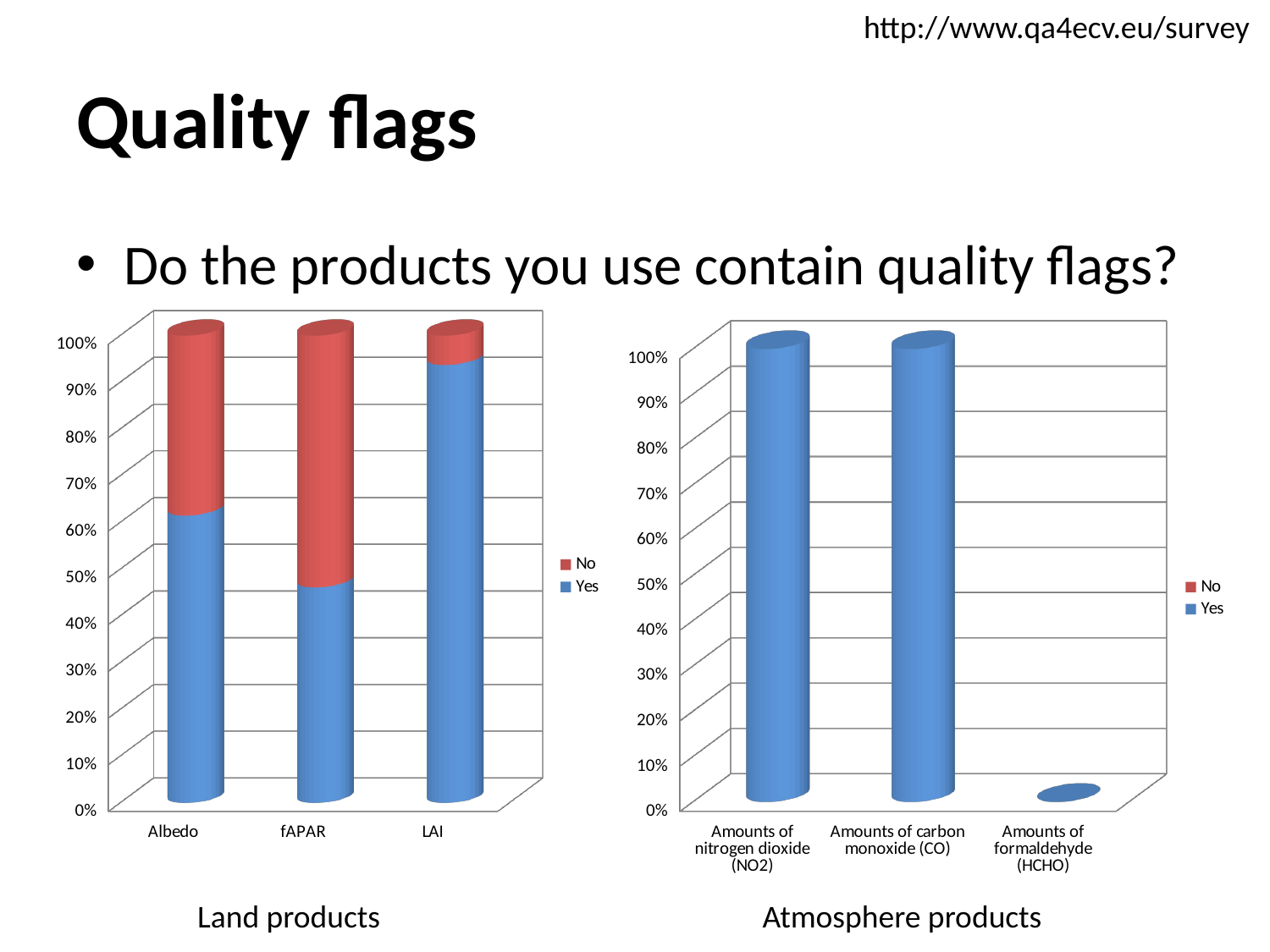
In the Land products chart, which category has the highest Yes share? LAI In the Land products chart, which colour represents the Yes series? Blue What kind of chart is the Atmosphere products chart? Stacked bar chart In the Land products chart, which category has the lowest Yes share? fAPAR In the Atmosphere products chart, which category has the lowest Yes share? Amounts of formaldehyde (HCHO) In the Atmosphere products chart, is the Yes value for Amounts of nitrogen dioxide (NO2) greater or less than 90%? greater In the Land products chart, is the Yes value for LAI greater or less than 90%? greater In the Land products chart, is the Yes value for Albedo greater or less than 50%? greater How many series does the legend of the Atmosphere products chart list? 2 How many categories are shown in the Land products chart? 3 In the Land products chart, which has the larger Yes share, Albedo or fAPAR? Albedo